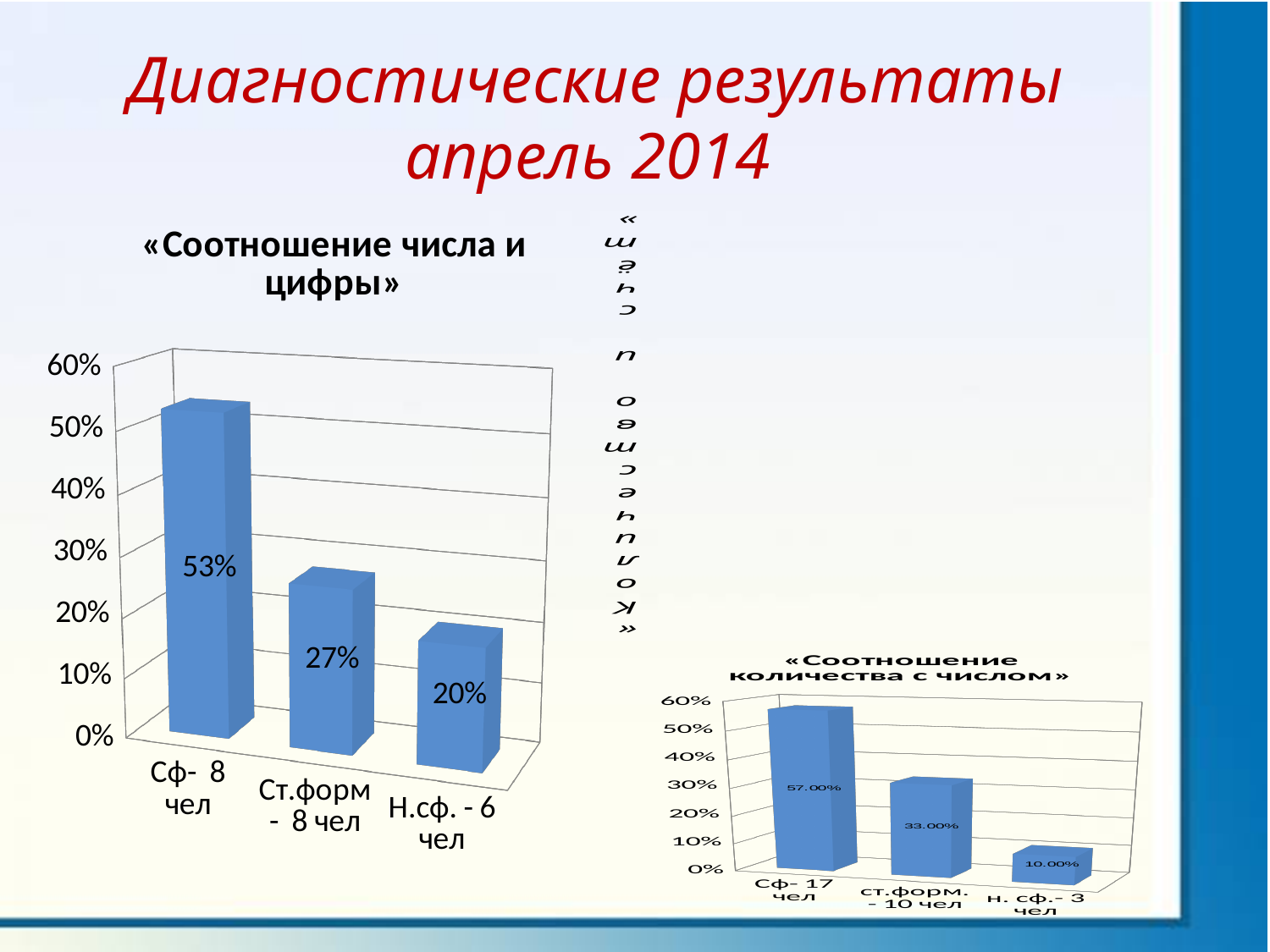
What type of chart is «Соотношение количества с числом»? bar chart In the chart «Соотношение количества с числом», what is the difference between the values for ст.форм. - 10 чел and н. сф.- 3 чел? 23.00% In the chart «Соотношение количества с числом», what is the value for ст.форм. - 10 чел? 33.00% In the chart «Соотношение количества с числом», which category has the lowest value? н. сф.- 3 чел In the chart «Соотношение числа и цифры», what is the value for Н.сф. - 6 чел? 20% In the chart «Соотношение числа и цифры», which category has the highest value? Сф- 8 чел In the chart «Соотношение числа и цифры», what is the difference between the values for Сф- 8 чел and Ст.форм - 8 чел? 26% In the chart «Соотношение числа и цифры», do the values rise or fall from left to right? fall In the chart «Соотношение числа и цифры», how many categories are shown? 3 Which is larger: the value for Сф- 8 чел in the chart «Соотношение числа и цифры» or the value for Сф- 17 чел in the chart «Соотношение количества с числом»? Сф- 17 чел In the chart «Соотношение числа и цифры», what is the value for Сф- 8 чел? 53% In the chart «Соотношение количества с числом», what is the value for Сф- 17 чел? 57.00%